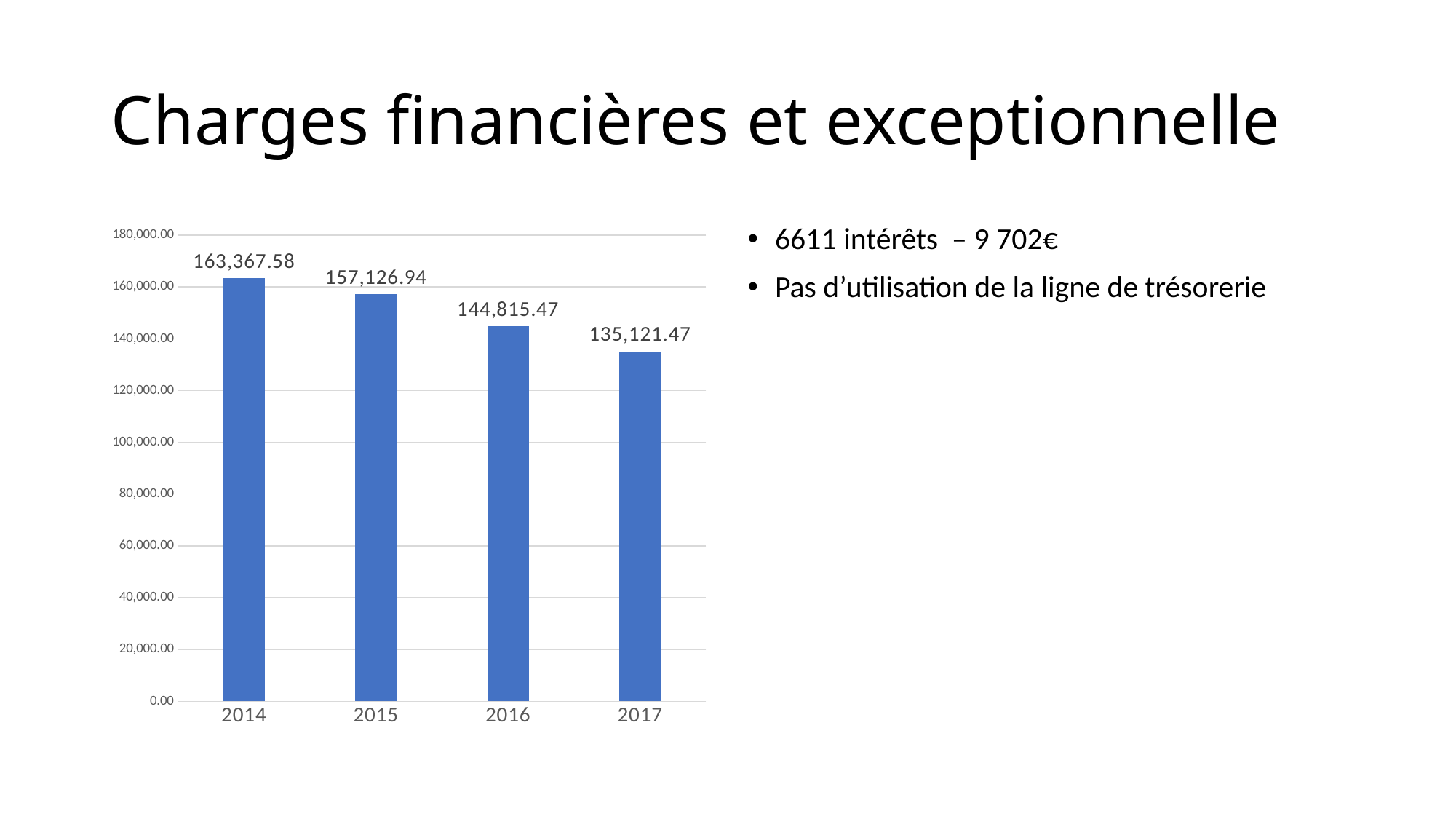
What kind of chart is shown on the slide? bar chart What is the value shown for 2016? 144,815.47 Is the value for 2017 greater or less than 140,000.00? less What is the difference between the values for 2014 and 2015? 6,240.64 Which year has the highest value? 2014 Which year has the lowest value? 2017 What is the value shown for 2015? 157,126.94 How many years are shown on the x axis? 4 What is the value shown for 2014? 163,367.58 What is the value shown for 2017? 135,121.47 Which is larger, the value for 2015 or the value for 2016? 2015 What is the difference between the values for 2016 and 2017? 9,694.00